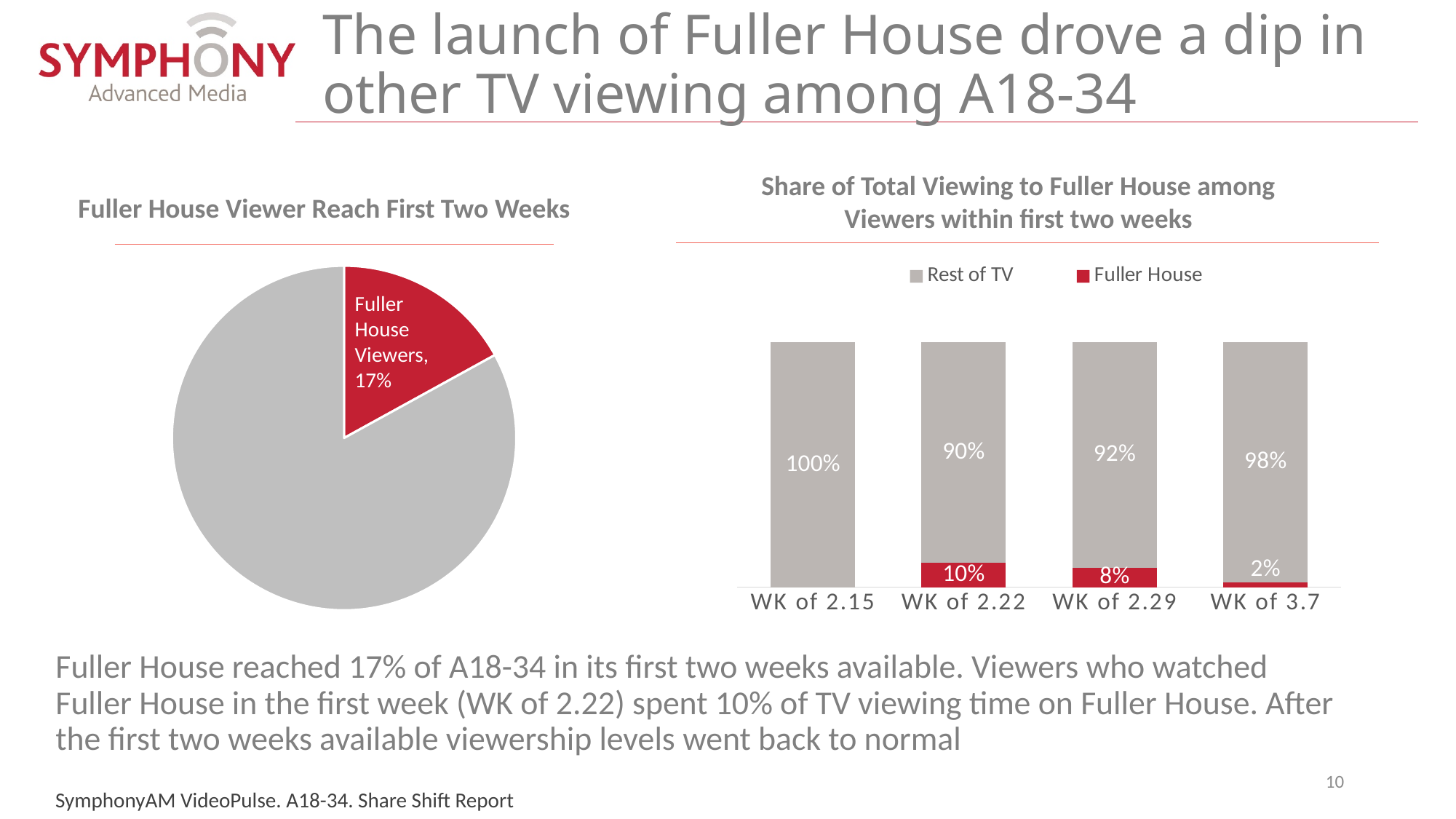
In the 'Fuller House Viewer Reach First Two Weeks' chart, what share of the pie is labelled Fuller House Viewers? 17% In the 'Share of Total Viewing to Fuller House' chart, which week has the lowest Rest of TV share? WK of 2.22 How many weeks are shown on the x axis of the 'Share of Total Viewing to Fuller House' chart? 4 In the 'Share of Total Viewing to Fuller House' chart, is the Rest of TV value larger for WK of 2.15 or WK of 3.7? WK of 2.15 In the 'Share of Total Viewing to Fuller House' chart, which week has the highest Fuller House share? WK of 2.22 In the 'Share of Total Viewing to Fuller House' chart, what is the difference between the Fuller House values for WK of 2.22 and WK of 2.29? 2% In the 'Share of Total Viewing to Fuller House' chart, what is the Fuller House value for WK of 2.22? 10% In the 'Share of Total Viewing to Fuller House' chart, what is the Rest of TV value for WK of 2.29? 92% What kind of chart is 'Fuller House Viewer Reach First Two Weeks'? Pie chart In the 'Share of Total Viewing to Fuller House' chart, what is the Fuller House value for WK of 3.7? 2% What kind of chart is 'Share of Total Viewing to Fuller House among Viewers within first two weeks'? Bar chart How many series does the legend of the 'Share of Total Viewing to Fuller House' chart list? 2